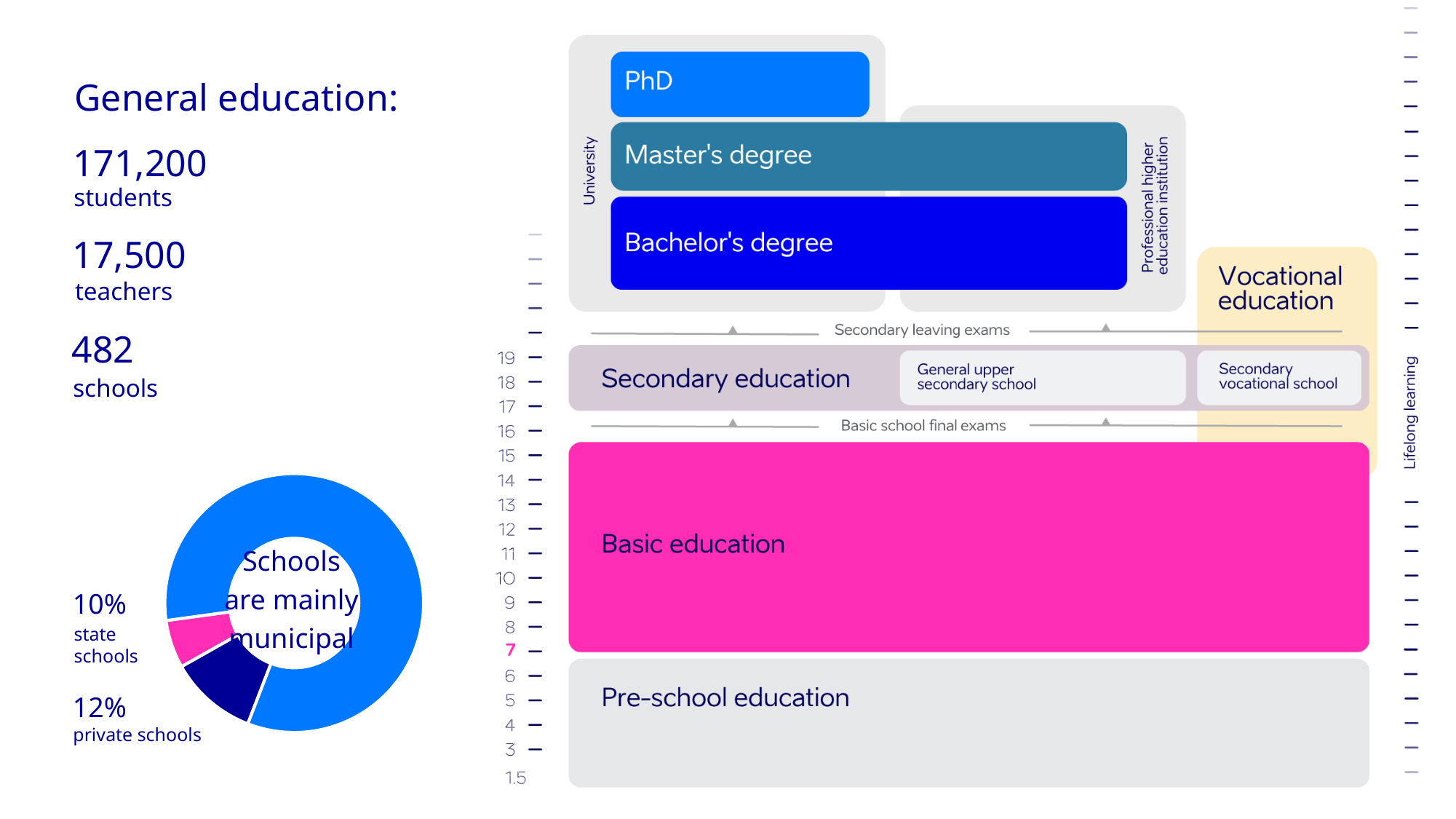
In the donut chart, which share is larger: state schools or private schools? Private schools In the donut chart, which slice is the smallest? State schools In the donut chart, what is the difference between the private schools share and the state schools share? 2% What kind of chart is shown on the left of the slide? Donut (pie) chart How many slices does the donut chart have? 3 In the donut chart, which slice is the largest? Municipal schools In the donut chart, what share of schools are private schools? 12% What text is written in the centre of the donut chart? Schools are mainly municipal In the donut chart, what share of schools are state schools? 10% What colour is the largest slice of the donut chart? Blue